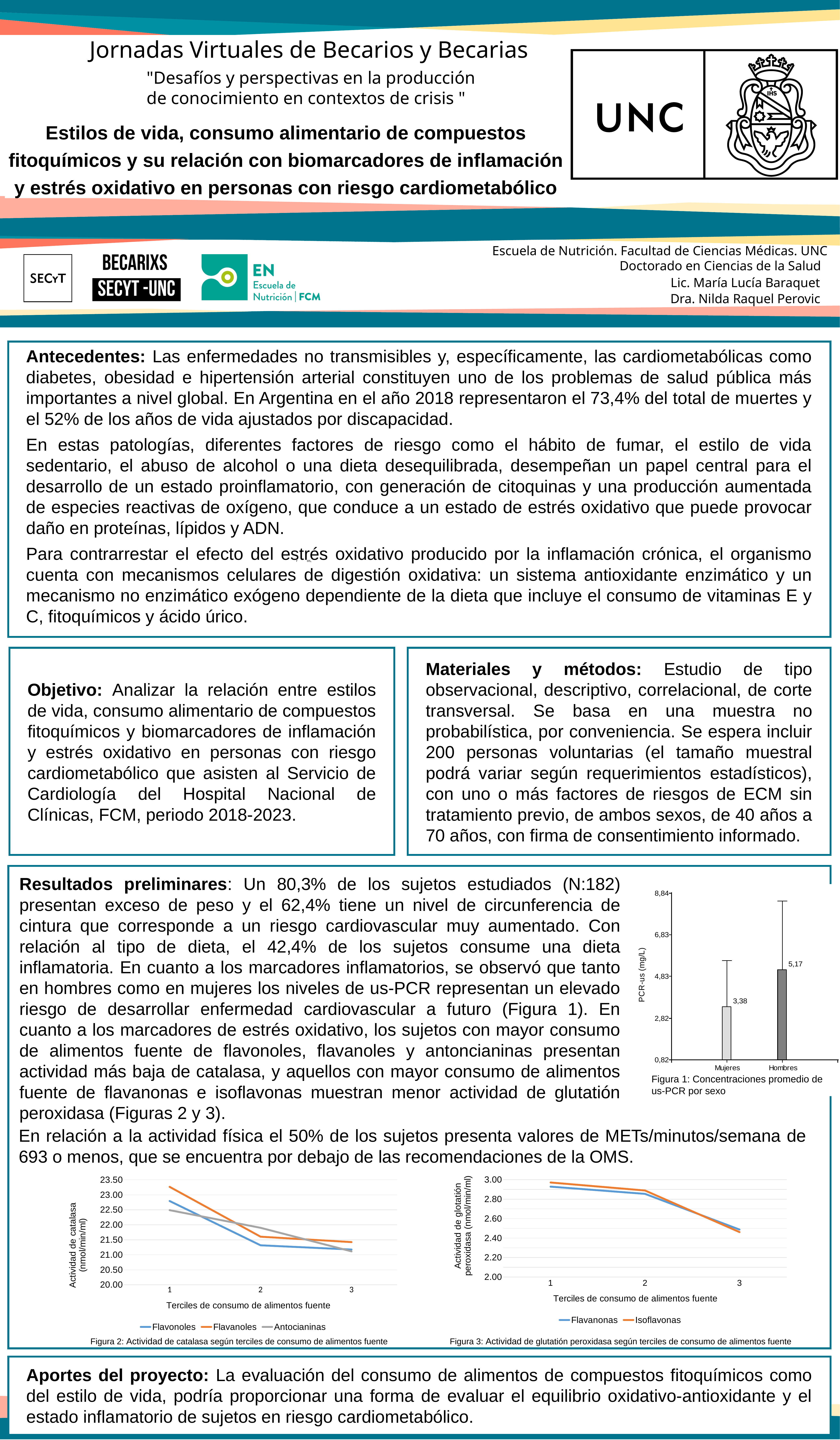
In Figura 2 (Actividad de catalasa según terciles de consumo de alimentos fuente), do the values for Flavonoles rise or fall from tercile 1 to tercile 3? Fall In Figura 2 (Actividad de catalasa según terciles de consumo de alimentos fuente), how many series does the legend list? 3 In Figura 1 (Concentraciones promedio de us-PCR por sexo), what is the value for Mujeres? 3,38 In Figura 3 (Actividad de glutatión peroxidasa según terciles de consumo de alimentos fuente), what kind of chart is shown? Line chart In Figura 2 (Actividad de catalasa según terciles de consumo de alimentos fuente), is the value for Flavanoles at tercile 1 greater or less than 23.00? greater In Figura 1 (Concentraciones promedio de us-PCR por sexo), what is the value for Hombres? 5,17 In Figura 2 (Actividad de catalasa según terciles de consumo de alimentos fuente), is the value for Flavonoles at tercile 3 greater or less than 21.50? less In Figura 1 (Concentraciones promedio de us-PCR por sexo), what is the difference between the values for Hombres and Mujeres? 1,79 In Figura 1 (Concentraciones promedio de us-PCR por sexo), what kind of chart is shown? Bar chart In Figura 3 (Actividad de glutatión peroxidasa según terciles de consumo de alimentos fuente), is the value for Isoflavonas at tercile 3 greater or less than 2.60? less In Figura 1 (Concentraciones promedio de us-PCR por sexo), which category has the higher value? Hombres In Figura 3 (Actividad de glutatión peroxidasa según terciles de consumo de alimentos fuente), how many series does the legend list? 2